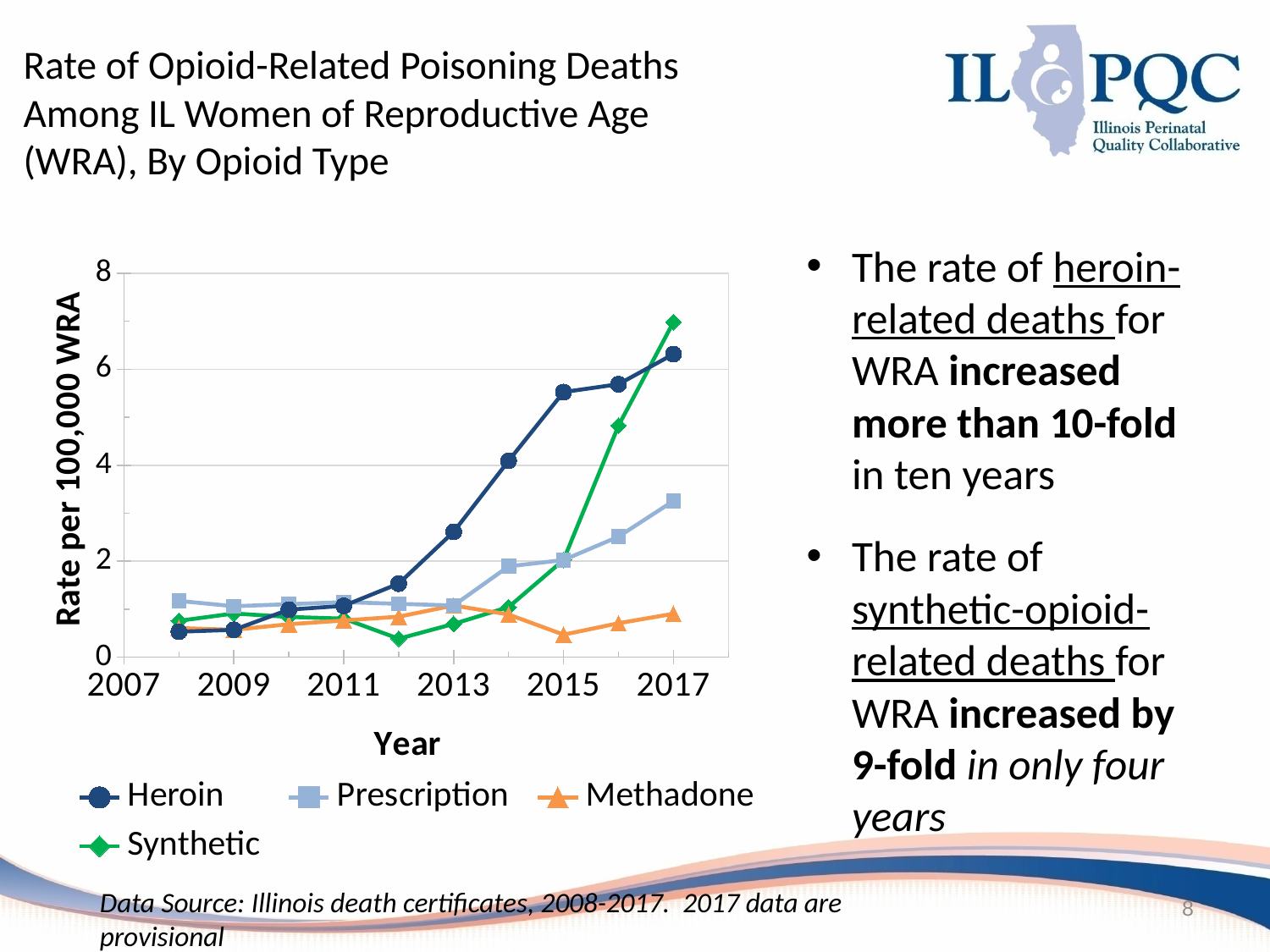
What kind of chart is shown on the slide? line chart Which series has the highest value in 2017? Synthetic Is the value for Prescription in 2017 greater or less than 2? greater In 2016, which is larger, the value for Heroin or the value for Methadone? Heroin Is the value for Synthetic in 2012 greater or less than 2? less What is the label on the x axis? Year Which series has the lowest value in 2017? Methadone Is the value for Heroin in 2017 greater or less than 6? greater Does the Heroin series generally rise or fall from 2008 to 2017? rise What is the label on the y axis? Rate per 100,000 WRA How many series does the legend list? 4